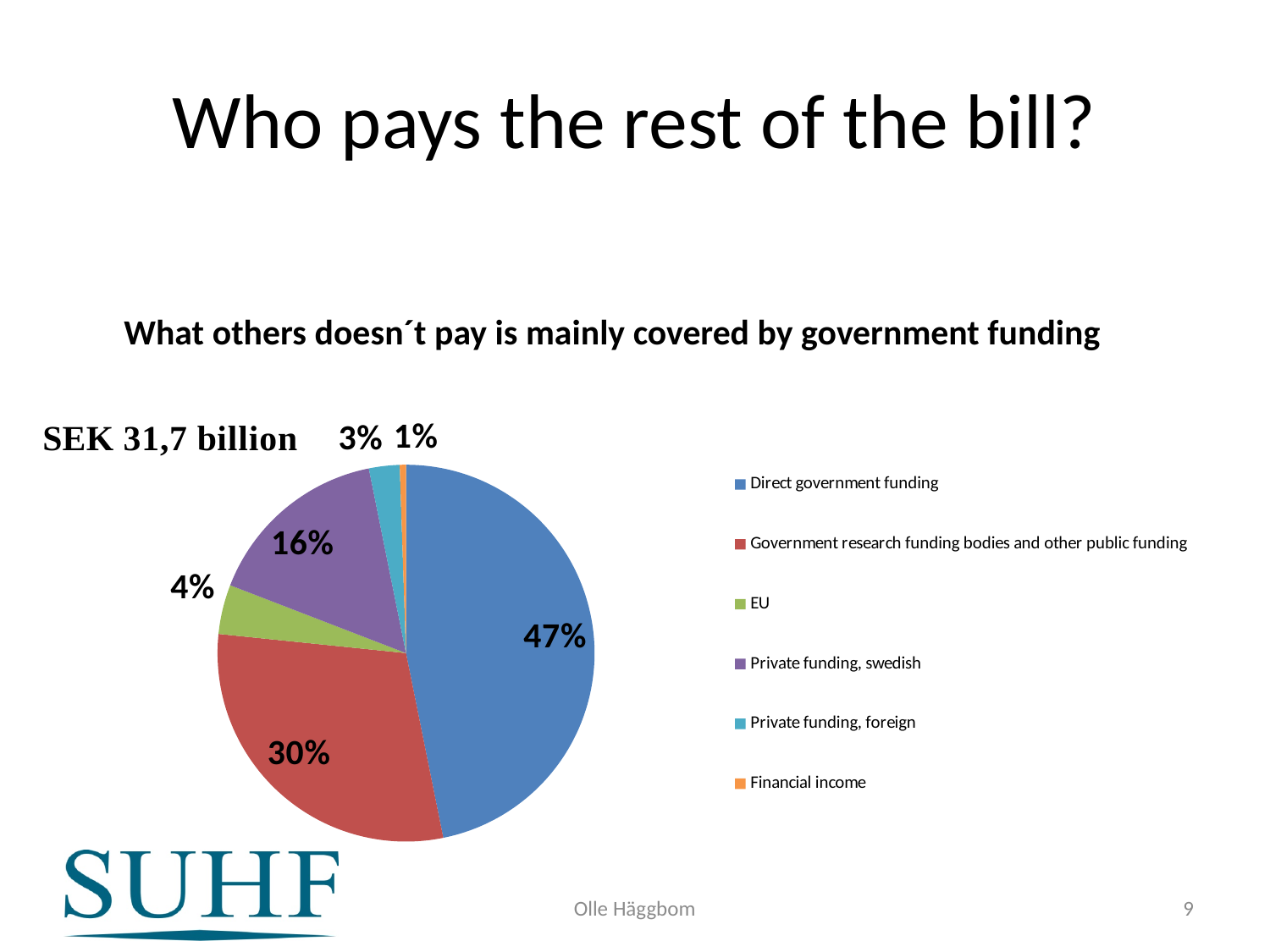
What share of the pie does Private funding, swedish represent? 16% Which is larger: the share for EU or the share for Private funding, foreign? EU Which category has the largest slice of the pie? Direct government funding What share of the pie does Private funding, foreign represent? 3% What share of the pie does Government research funding bodies and other public funding represent? 30% What kind of chart is shown on the slide? pie chart How many categories does the legend list? 6 Which category has the smallest slice of the pie? Financial income What is the difference in percentage points between Direct government funding and Private funding, swedish? 31